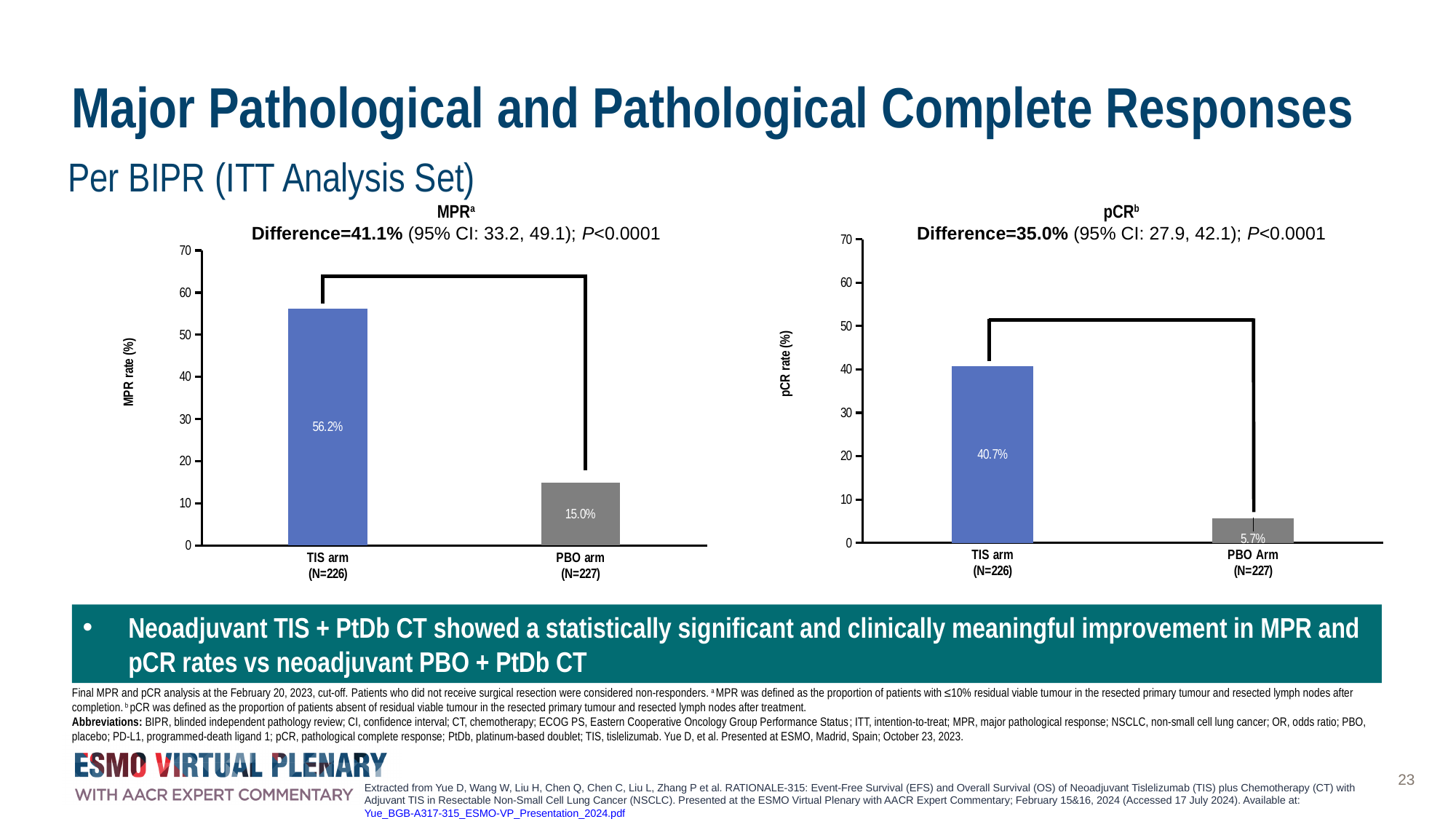
In the pCR chart on the right, which arm has the lower pCR rate? PBO Arm In the pCR chart on the right, what is the pCR rate for the PBO Arm? 5.7% What type of chart is the MPR chart on the left? Bar chart In the pCR chart on the right, what is the difference between the TIS arm and PBO Arm pCR rates? 35.0% How many bars are shown in the pCR chart on the right? 2 In the pCR chart on the right, what is the pCR rate for the TIS arm? 40.7% In the MPR chart on the left, is the value for the TIS arm greater or less than 50? greater In the MPR chart on the left, what is the MPR rate for the TIS arm? 56.2% In the MPR chart on the left, which arm has the higher MPR rate? TIS arm In the MPR chart on the left, what is the difference between the TIS arm and PBO arm MPR rates? 41.1% In the MPR chart on the left, what is the MPR rate for the PBO arm? 15.0% In the pCR chart on the right, is the value for the PBO Arm greater or less than 10? less